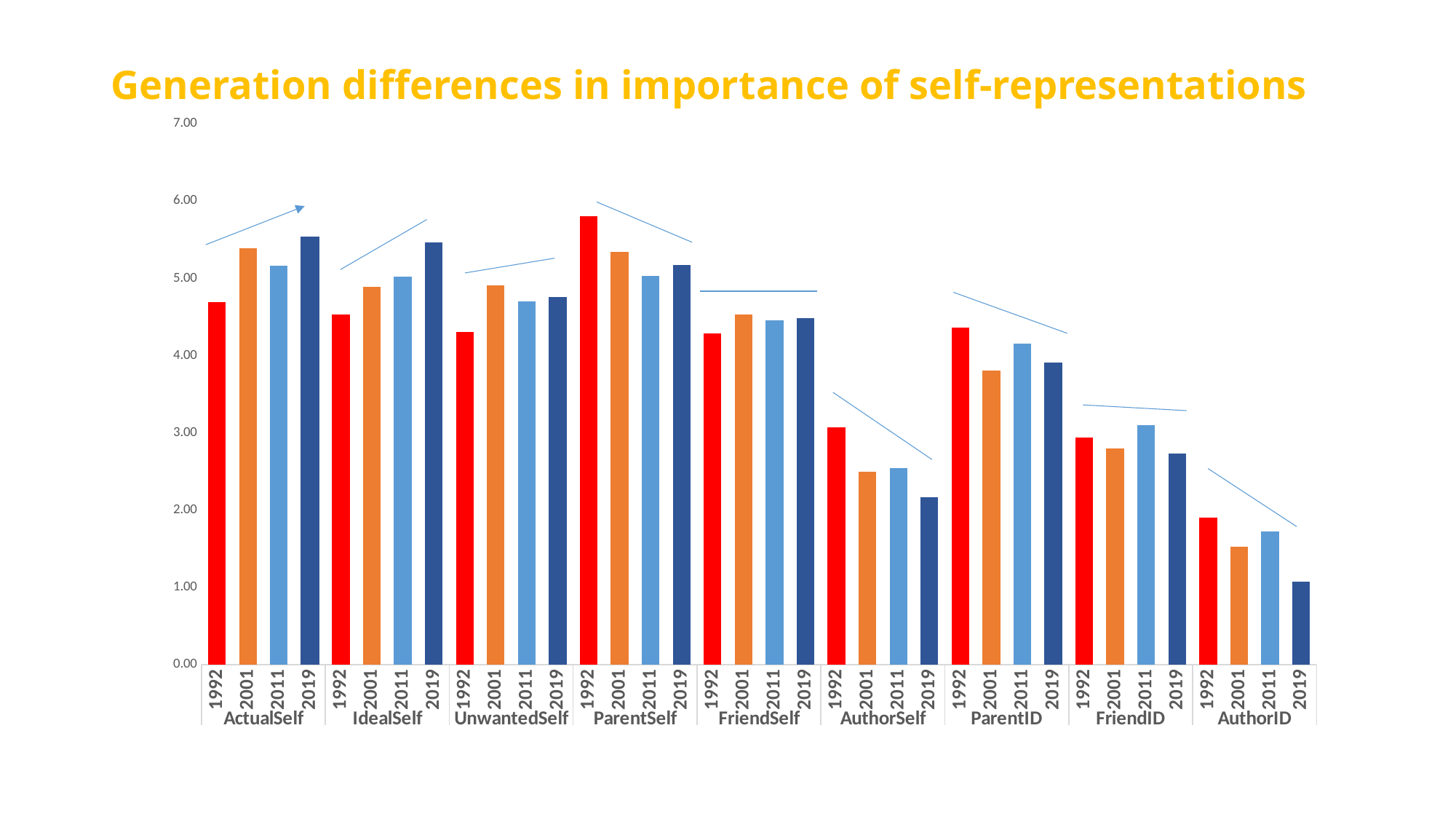
Is the value for AuthorID in 2019 greater or less than 2.00? less Which group and year has the shortest bar in the chart? AuthorID, 2019 What kind of chart is shown on the slide? Bar chart How many self-representation groups are shown along the x axis? 9 Which is larger for ActualSelf: the 1992 value or the 2019 value? 2019 How many years are plotted within each self-representation group? 4 What is the title of the chart? Generation differences in importance of self-representations Which group and year has the tallest bar in the chart? ParentSelf, 1992 Do the values for AuthorSelf rise or fall from 1992 to 2019? fall Is the value for ActualSelf in 1992 greater or less than 5.00? less Which is larger in 1992: AuthorSelf or ParentID? ParentID Is the value for ParentSelf in 1992 greater or less than 5.00? greater